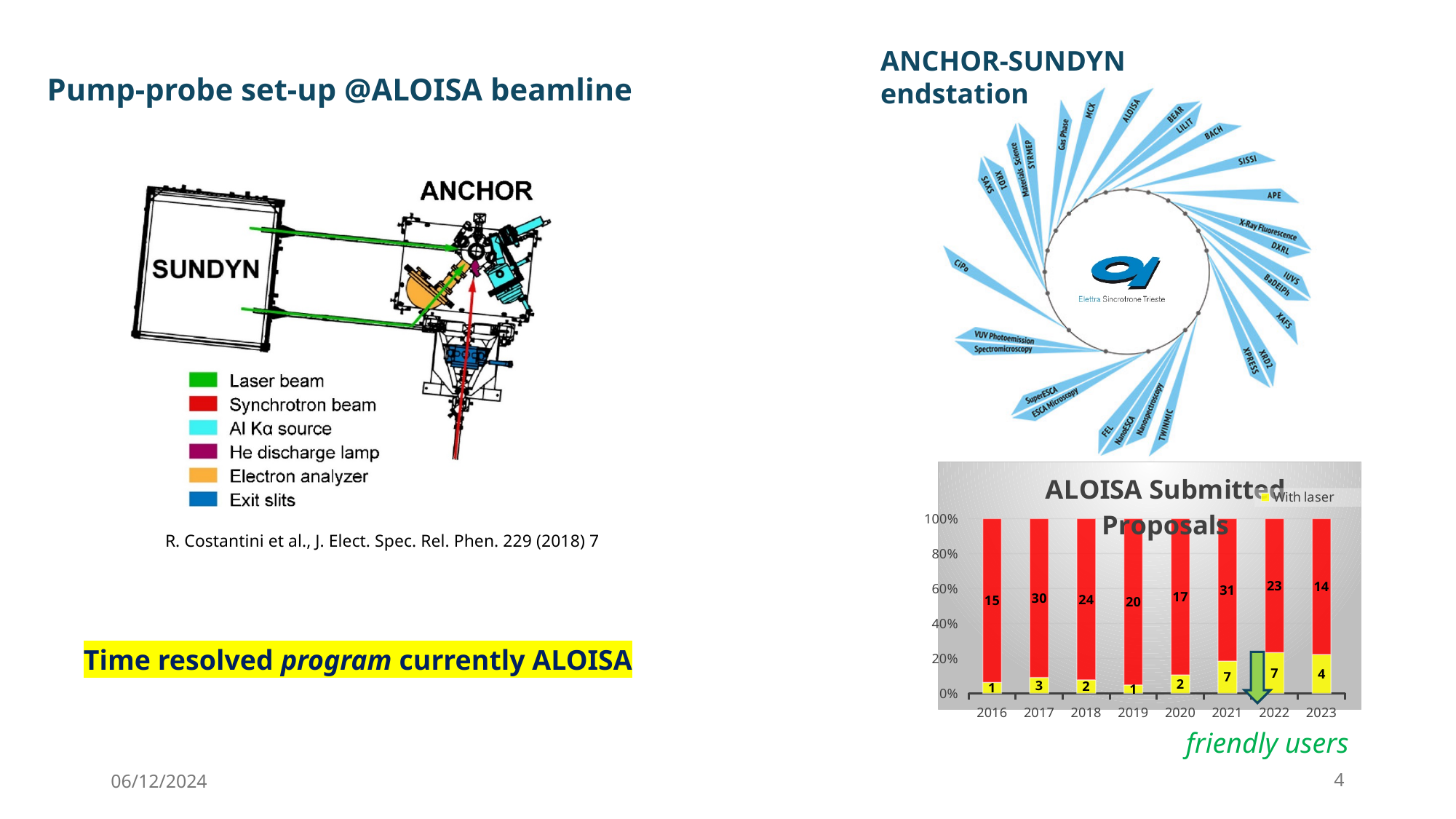
How many years are shown on the x axis of the ALOISA Submitted Proposals chart? 8 In the ALOISA Submitted Proposals chart, what is the value of the red segment for 2017? 30 What kind of chart is the ALOISA Submitted Proposals chart? bar chart In the ALOISA Submitted Proposals chart, what is the total of the two segments for 2021? 38 In the ALOISA Submitted Proposals chart, what is the value of the 'With laser' segment for 2023? 4 What is the title of the chart on the slide? ALOISA Submitted Proposals In the ALOISA Submitted Proposals chart, what is the difference between the red segment values for 2021 and 2016? 16 In the ALOISA Submitted Proposals chart, what colour are the 'With laser' segments? yellow In the ALOISA Submitted Proposals chart, which year has the lowest value for the red segment? 2023 In the ALOISA Submitted Proposals chart, is the red segment value larger for 2017 or 2018? 2017 In the ALOISA Submitted Proposals chart, which year has the highest value for the red segment? 2021 In the ALOISA Submitted Proposals chart, what is the value of the 'With laser' segment for 2021? 7